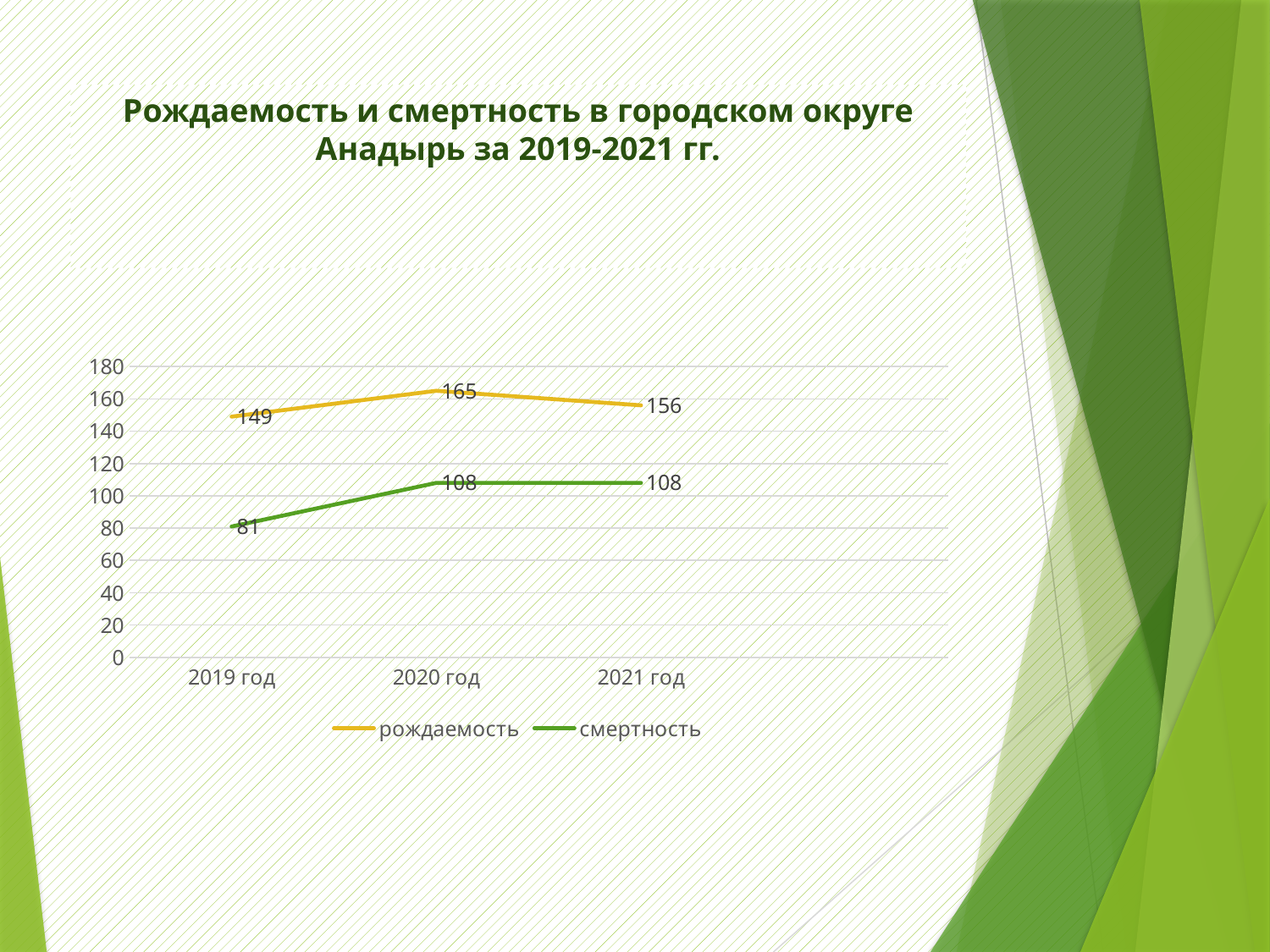
How many series does the legend list? 2 What is the value for смертность in 2019 год? 81 Which is larger in 2021 год, рождаемость or смертность? рождаемость In which year is рождаемость highest? 2020 год How many years are shown on the x axis? 3 What is the difference between рождаемость and смертность in 2019 год? 68 What is the value for рождаемость in 2021 год? 156 In which year is смертность lowest? 2019 год What is the value for рождаемость in 2020 год? 165 Does смертность rise or fall from 2019 год to 2020 год? rise Is the value for смертность in 2020 год greater or less than 100? greater What kind of chart is shown on the slide? line chart